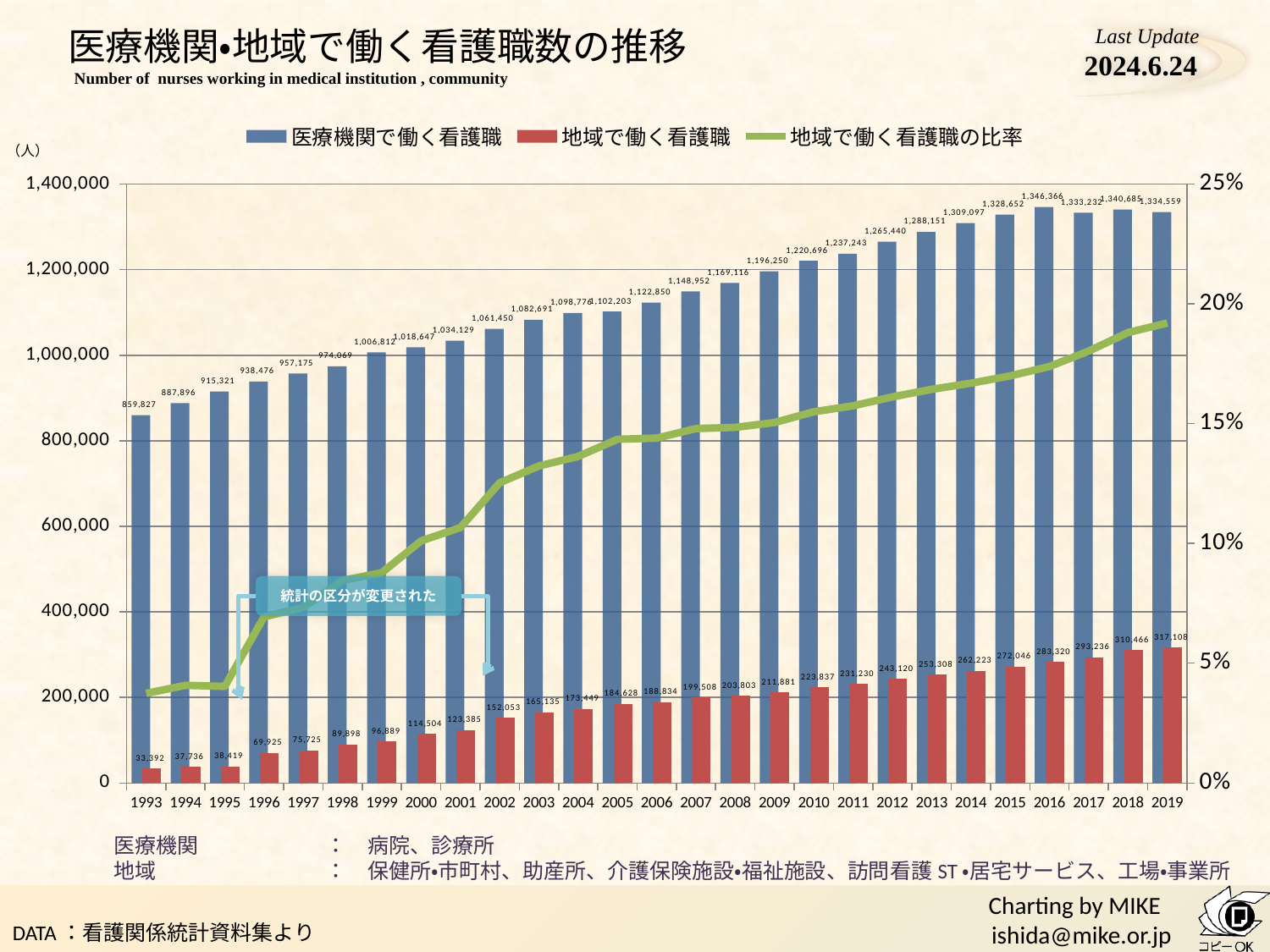
How many series does the legend list? 3 What is the value for 地域で働く看護職 in 1993? 33,392 Does the 地域で働く看護職 series rise or fall from 1993 to 2019? rise What is the value for 医療機関で働く看護職 in 2016? 1,346,366 Is the 地域で働く看護職の比率 value for 2019 greater or less than 15%? greater What is the difference between the 地域で働く看護職 values for 2019 and 2018? 6,642 In which year is the value for 地域で働く看護職 lowest? 1993 Which is larger, the 医療機関で働く看護職 value for 2017 or for 2018? 2018 What is the value for 地域で働く看護職 in 2019? 317,108 How many years are shown on the x axis? 27 In which year is the value for 医療機関で働く看護職 highest? 2016 What is the difference between the 医療機関で働く看護職 values for 2019 and 1993? 474,732